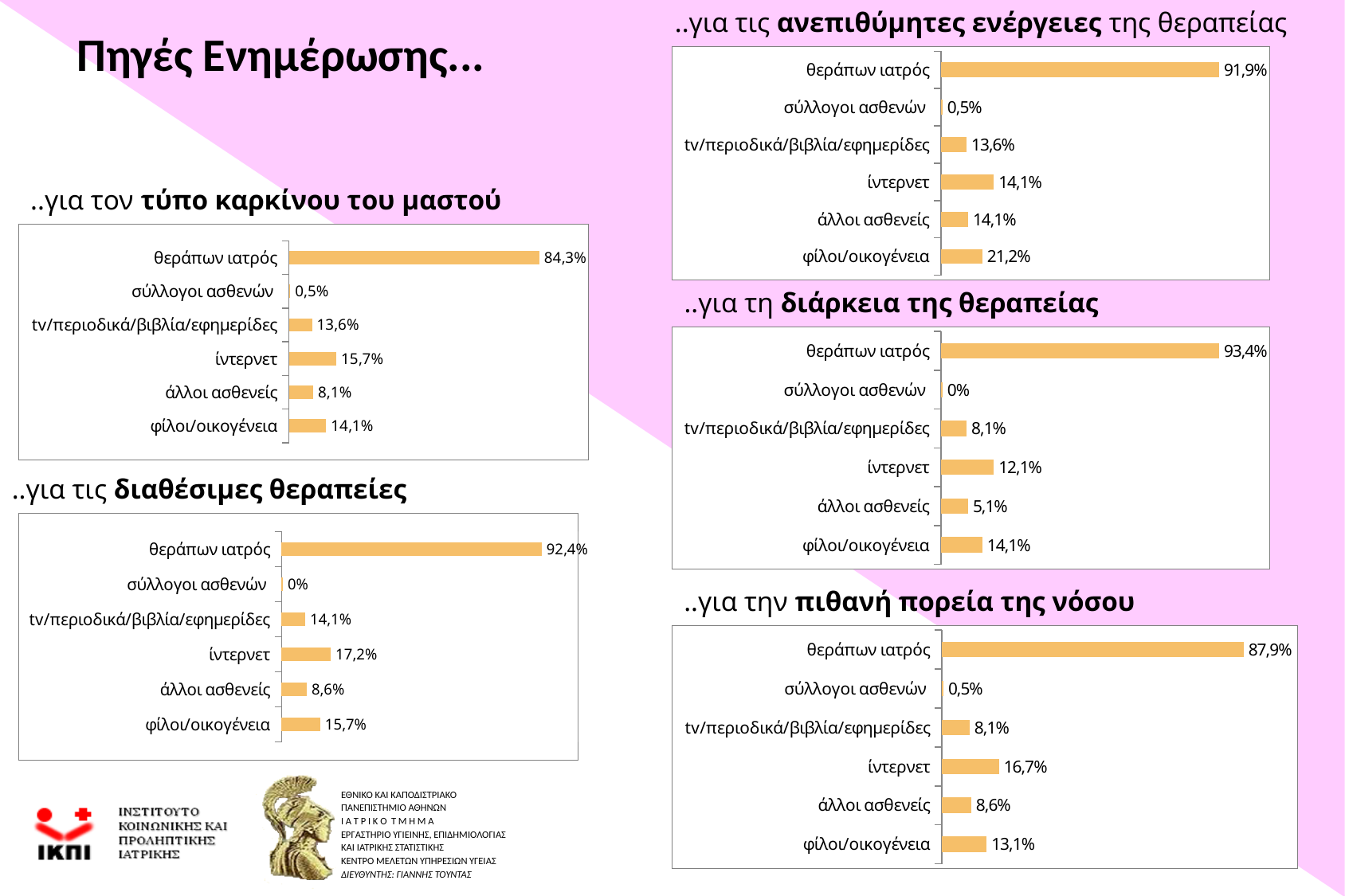
How many bar charts are shown on the slide? 5 In the chart titled '..για τις ανεπιθύμητες ενέργειες της θεραπείας', what is the difference between 'ίντερνετ' and 'tv/περιοδικά/βιβλία/εφημερίδες'? 0,5% How many categories are shown in the chart titled '..για την πιθανή πορεία της νόσου'? 6 In the chart titled '..για την πιθανή πορεία της νόσου', what is the value for 'άλλοι ασθενείς'? 8,6% In the chart titled '..για τις ανεπιθύμητες ενέργειες της θεραπείας', what is the value for 'φίλοι/οικογένεια'? 21,2% In the chart titled '..για τον τύπο καρκίνου του μαστού', what is the value for 'θεράπων ιατρός'? 84,3% What kind of chart is the one titled '..για τον τύπο καρκίνου του μαστού'? bar chart In the chart titled '..για τις διαθέσιμες θεραπείες', which is larger: 'ίντερνετ' or 'φίλοι/οικογένεια'? ίντερνετ In the chart titled '..για την πιθανή πορεία της νόσου', which category has the highest value? θεράπων ιατρός In the chart titled '..για τη διάρκεια της θεραπείας', which category has the lowest value? σύλλογοι ασθενών In the chart titled '..για τη διάρκεια της θεραπείας', what is the difference between 'θεράπων ιατρός' and 'φίλοι/οικογένεια'? 79,3% In the chart titled '..για τις διαθέσιμες θεραπείες', what is the value for 'ίντερνετ'? 17,2%